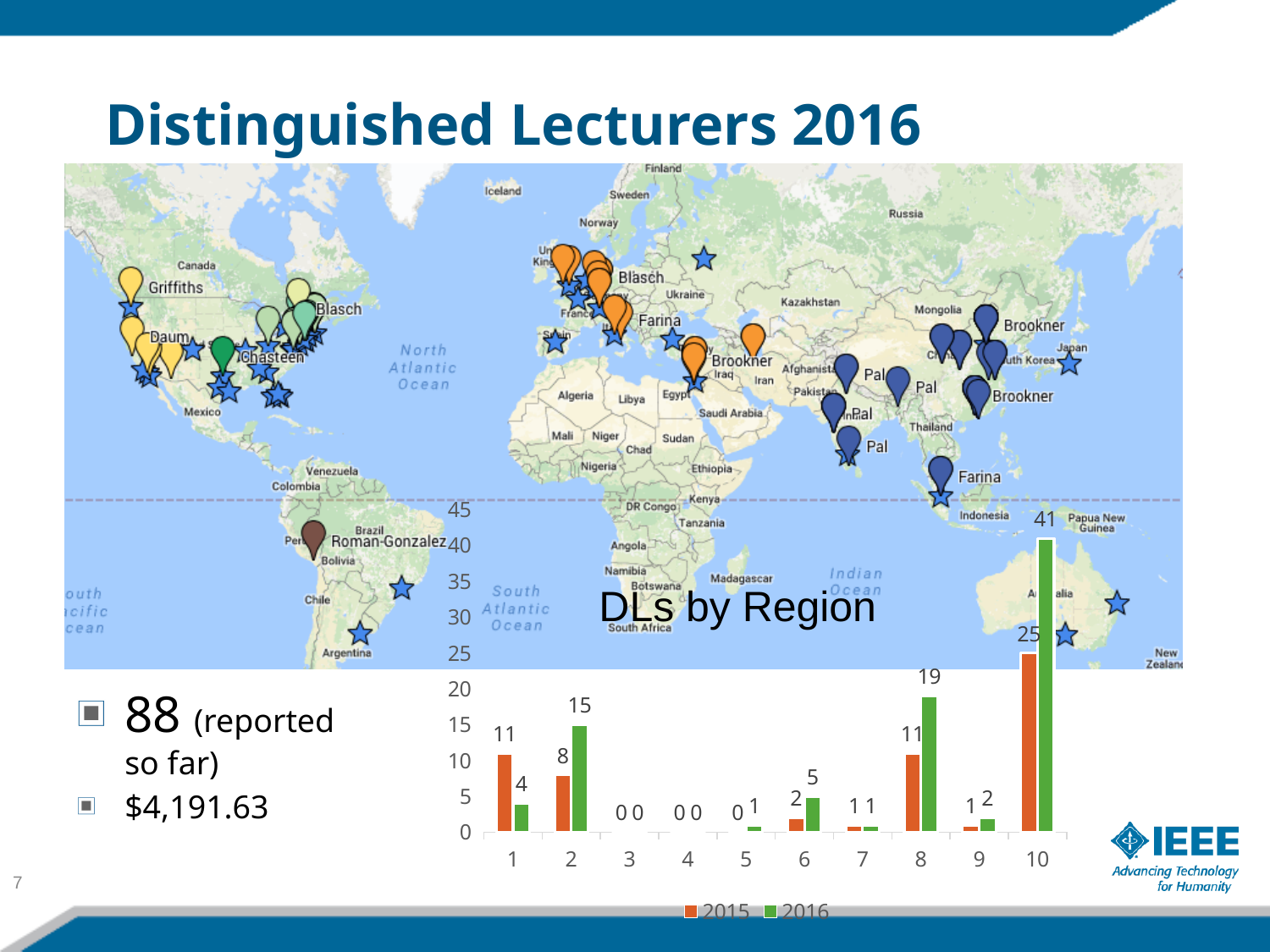
In the DLs by Region chart, what is the difference between the 2015 and 2016 values for region 1? 7 What kind of chart is the DLs by Region chart? bar chart In the DLs by Region chart, which region has the highest 2015 value? 10 How many series does the legend of the DLs by Region chart list? 2 How many regions are shown on the x axis of the DLs by Region chart? 10 In the DLs by Region chart, what is the 2016 value for region 2? 15 In the DLs by Region chart, which region has the highest 2016 value? 10 In the DLs by Region chart, what is the difference between the 2016 and 2015 values for region 10? 16 In the DLs by Region chart, is the 2016 value for region 10 greater or less than 35? greater In the DLs by Region chart, what is the 2016 value for region 10? 41 In the DLs by Region chart, which is larger for region 8: the 2015 value or the 2016 value? 2016 In the DLs by Region chart, what is the 2015 value for region 8? 11